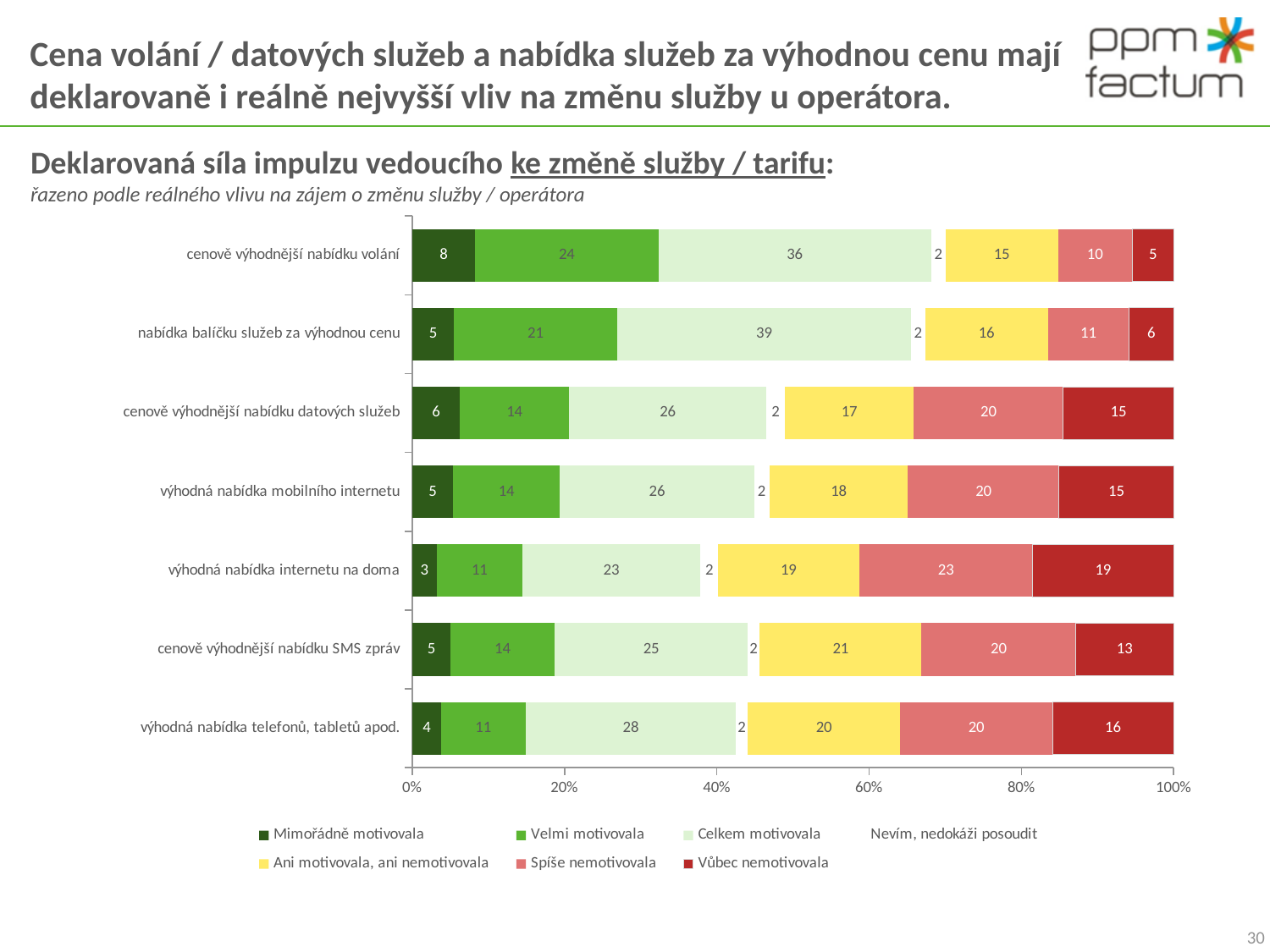
What is the value of "Vůbec nemotivovala" for "výhodná nabídka internetu na doma"? 19 How many categories are shown on the chart? 7 What is the value of "Ani motivovala, ani nemotivovala" for "cenově výhodnější nabídku SMS zpráv"? 21 What is the value of "Mimořádně motivovala" for "cenově výhodnější nabídku volání"? 8 What is the value of "Celkem motivovala" for "nabídka balíčku služeb za výhodnou cenu"? 39 Which category has the highest value for "Velmi motivovala"? cenově výhodnější nabídku volání What kind of chart is shown on the slide? stacked bar chart Which is larger: the "Spíše nemotivovala" value for "cenově výhodnější nabídku volání" or for "cenově výhodnější nabídku datových služeb"? cenově výhodnější nabídku datových služeb How many series does the legend list? 7 What is the difference between the "Celkem motivovala" values for "nabídka balíčku služeb za výhodnou cenu" and "výhodná nabídka internetu na doma"? 16 Which category has the lowest value for "Mimořádně motivovala"? výhodná nabídka internetu na doma